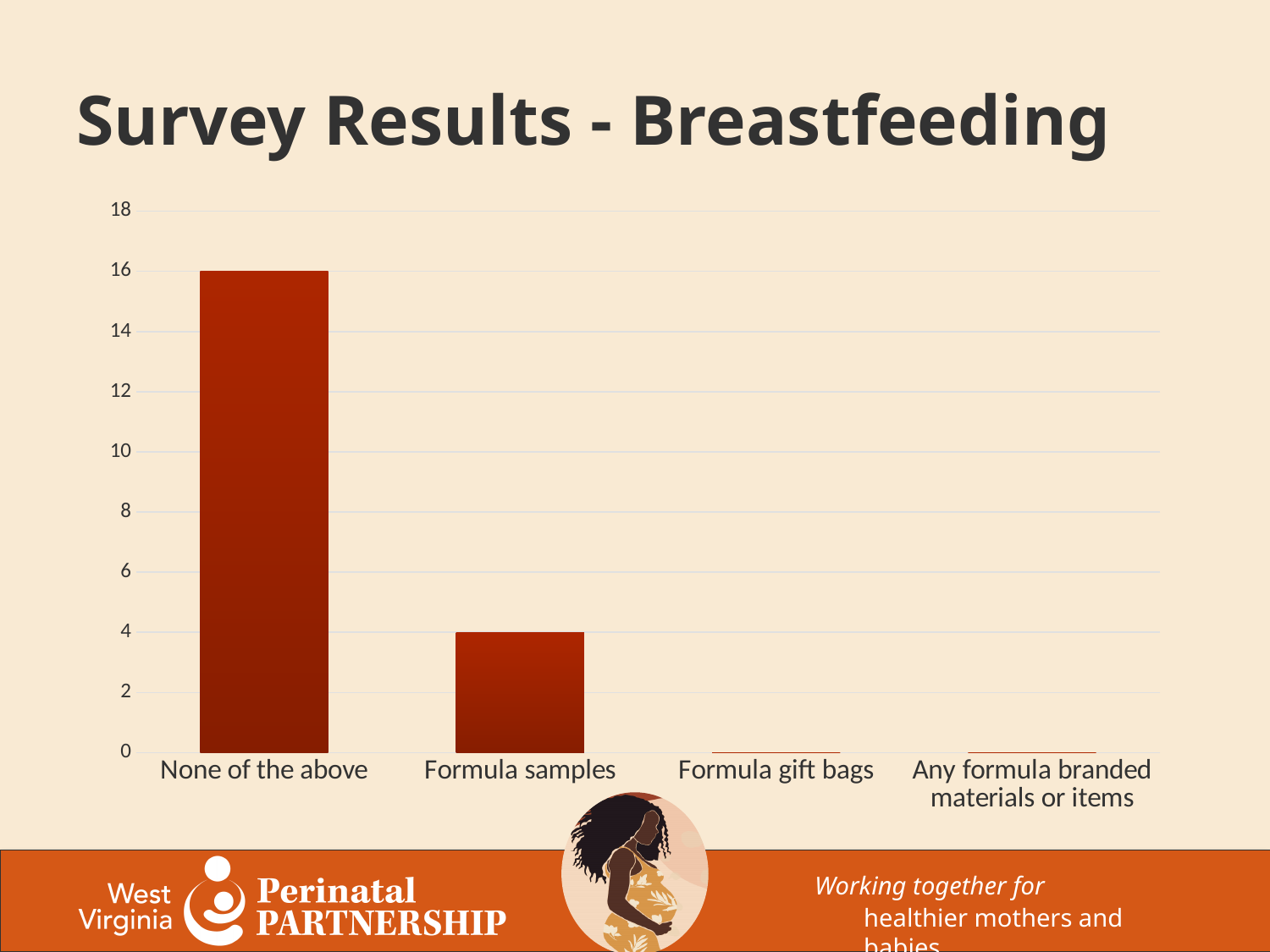
What is the value for Formula samples? 4 Is the value for Formula samples greater or less than 8? less What is the difference between the values for None of the above and Formula samples? 12 What is the value for Formula gift bags? 0 How many categories are shown on the x axis? 4 Which is larger, the value for None of the above or the value for Formula samples? None of the above Which category has the highest value? None of the above What is the value for None of the above? 16 Do the values rise or fall moving from left to right along the x axis? fall What kind of chart is shown on the slide? bar chart Is the value for None of the above greater or less than 10? greater What is the title of the slide? Survey Results - Breastfeeding